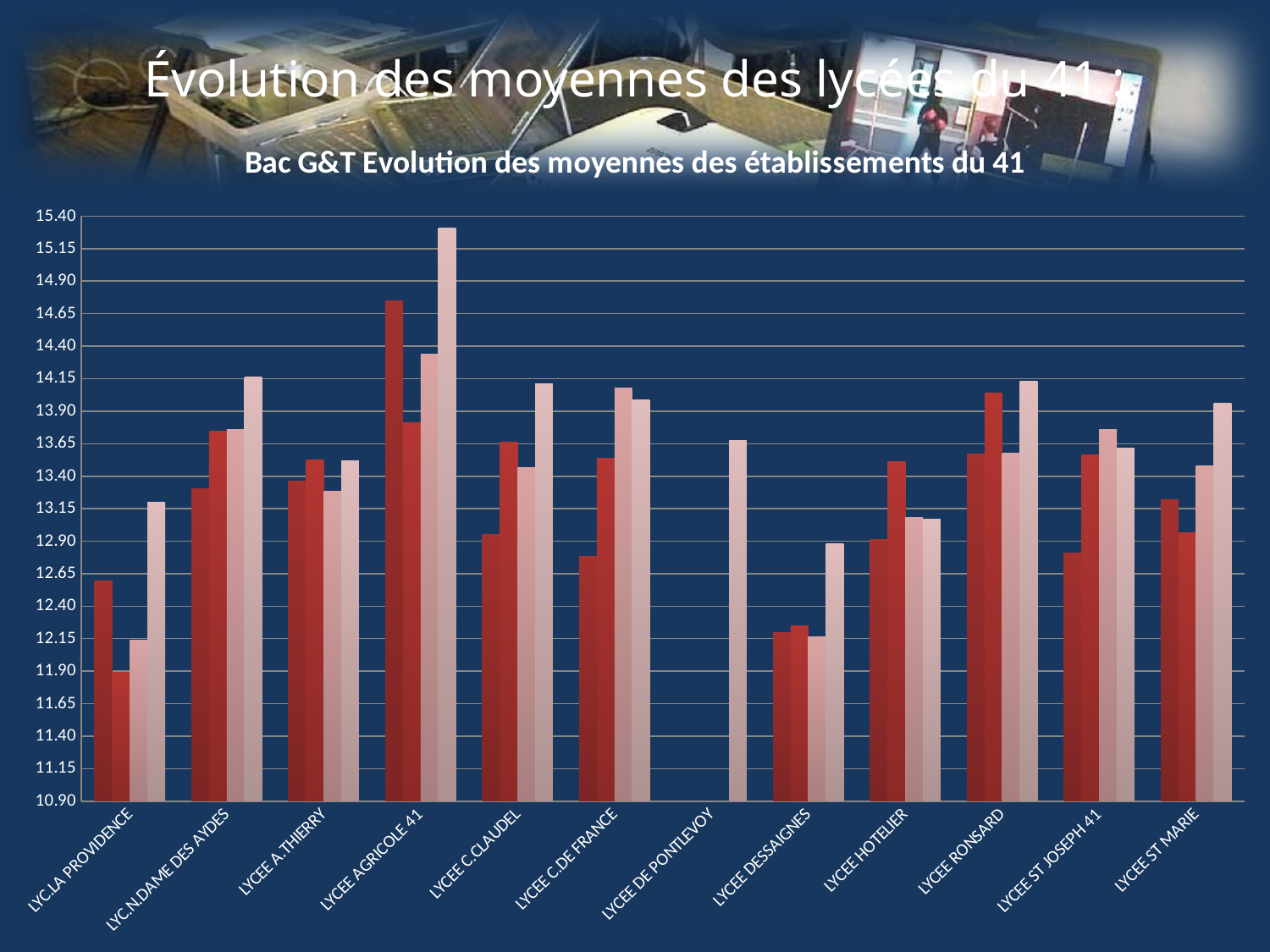
Which lycée has a higher tallest bar, LYCEE DESSAIGNES or LYCEE HOTELIER? LYCEE HOTELIER Is the tallest bar for LYCEE DESSAIGNES greater or less than 13.15? less Is the tallest bar for LYCEE AGRICOLE 41 greater or less than 14.90? greater How many bars are shown for LYCEE DE PONTLEVOY? 1 Which lycée has a higher tallest bar, LYCEE AGRICOLE 41 or LYCEE RONSARD? LYCEE AGRICOLE 41 Which lycée has the shortest bar in the chart? LYC.LA PROVIDENCE Is the value of the bar for LYCEE DE PONTLEVOY greater or less than 13.40? greater What is the title of the chart? Bac G&T Evolution des moyennes des établissements du 41 Which lycée has the tallest bar in the chart? LYCEE AGRICOLE 41 How many lycées (categories) are shown on the x axis of the chart? 12 What kind of chart is shown on the slide? bar chart